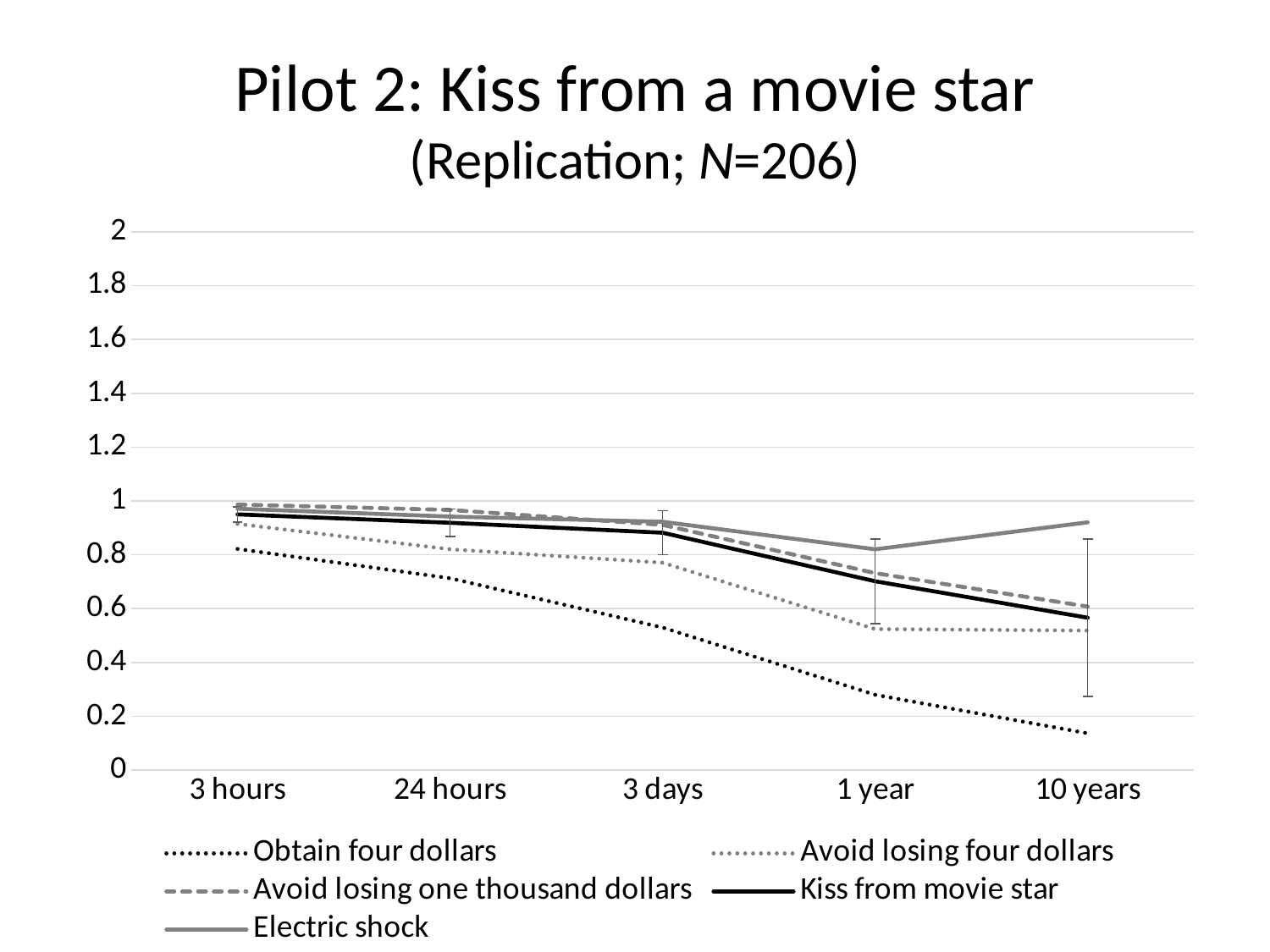
Which series has the lowest value at 10 years? Obtain four dollars Is the value for Avoid losing four dollars at 1 year greater or less than 0.6? less How many series does the legend list? 5 Which series is drawn as a solid black line? Kiss from movie star How many time points are shown on the x axis? 5 Which series has the highest value at 10 years? Electric shock Is the value for Obtain four dollars at 10 years greater or less than 0.2? less Do the values for Obtain four dollars rise or fall from 3 hours to 10 years? fall Is the value for Obtain four dollars at 24 hours greater or less than 0.8? less What kind of chart is shown on the slide? line chart At 1 year, which is larger: the value for Electric shock or the value for Obtain four dollars? Electric shock